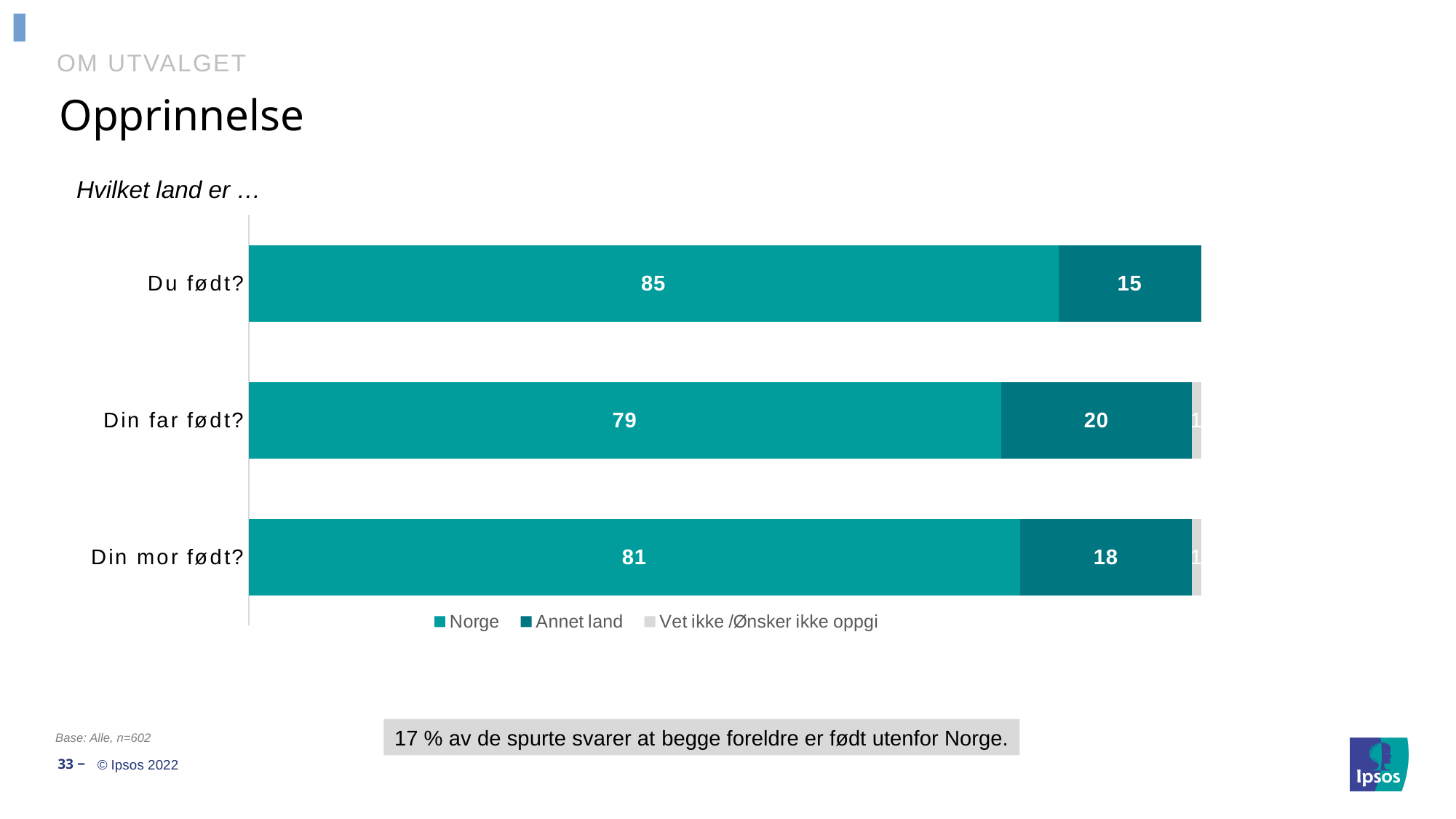
How many series does the legend list? 3 What is the value for "Annet land" in the "Du født?" bar? 15 What is the value for "Norge" in the "Din mor født?" bar? 81 What is the value for "Norge" in the "Du født?" bar? 85 Which category has the lowest value for "Norge"? Din far født? How many categories are shown on the chart? 3 What is the total of the "Din mor født?" stacked bar? 100 What is the value for "Annet land" in the "Din far født?" bar? 20 Which category has the highest value for "Norge"? Du født? Which is larger: the "Annet land" value for "Din far født?" or for "Din mor født?"? Din far født? What is the difference between the "Norge" values for "Du født?" and "Din far født?"? 6 What kind of chart is shown on the slide? Stacked bar chart